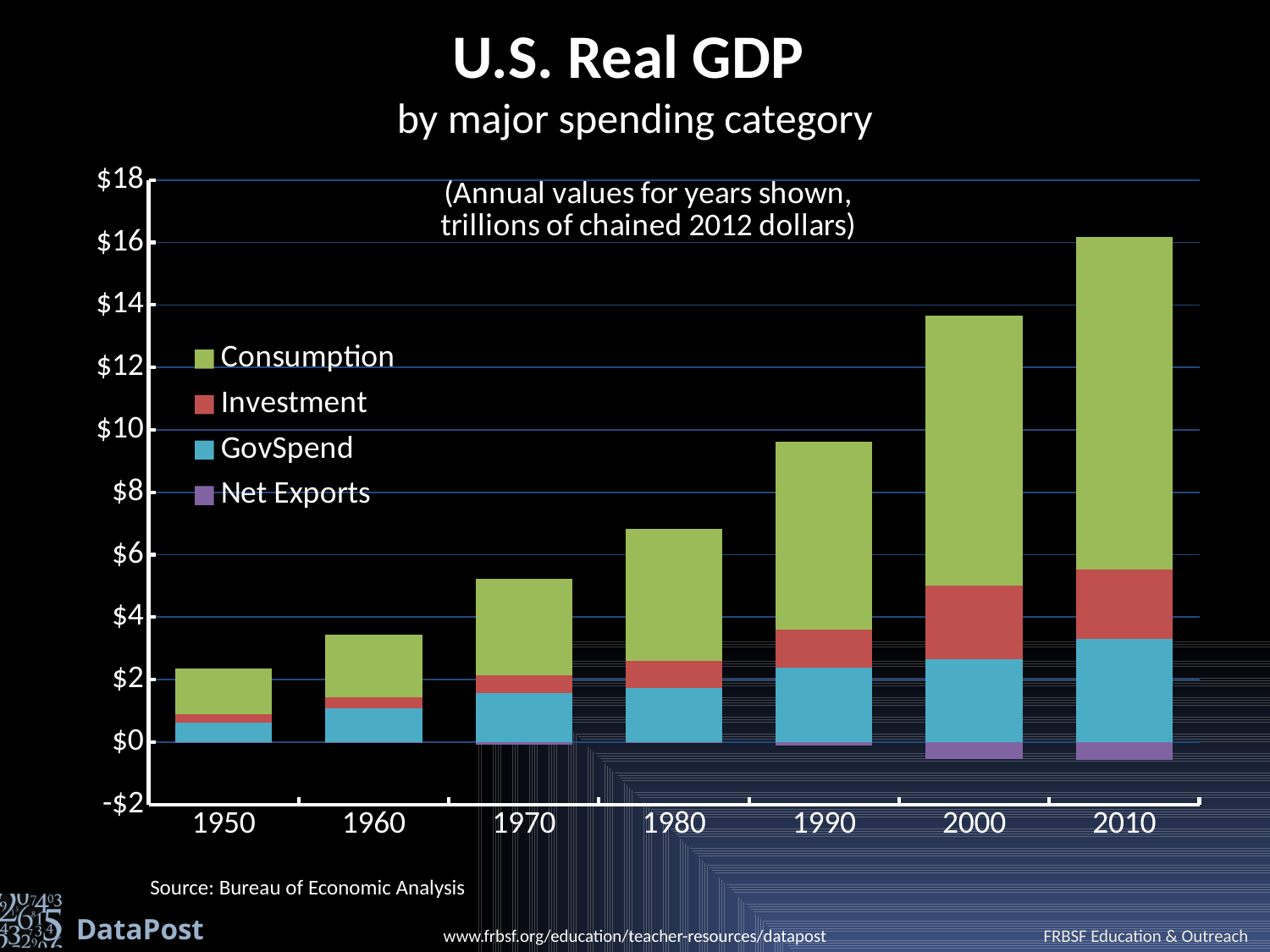
What is the title of the chart? U.S. Real GDP by major spending category Which year has the tallest bar (highest real GDP)? 2010 Is the top of the bar for 1980 greater or less than $6? greater Which series is shown in green in the legend? Consumption How many years (bars) are shown on the x axis? 7 Is the top of the bar for 1960 greater or less than $4? less How many series does the legend list? 4 Is the top of the bar for 2010 greater or less than $14? greater Do the bar heights rise or fall from 1950 to 2010? Rise What kind of chart is shown on the slide? Stacked bar chart Which year has the shortest bar (lowest real GDP)? 1950